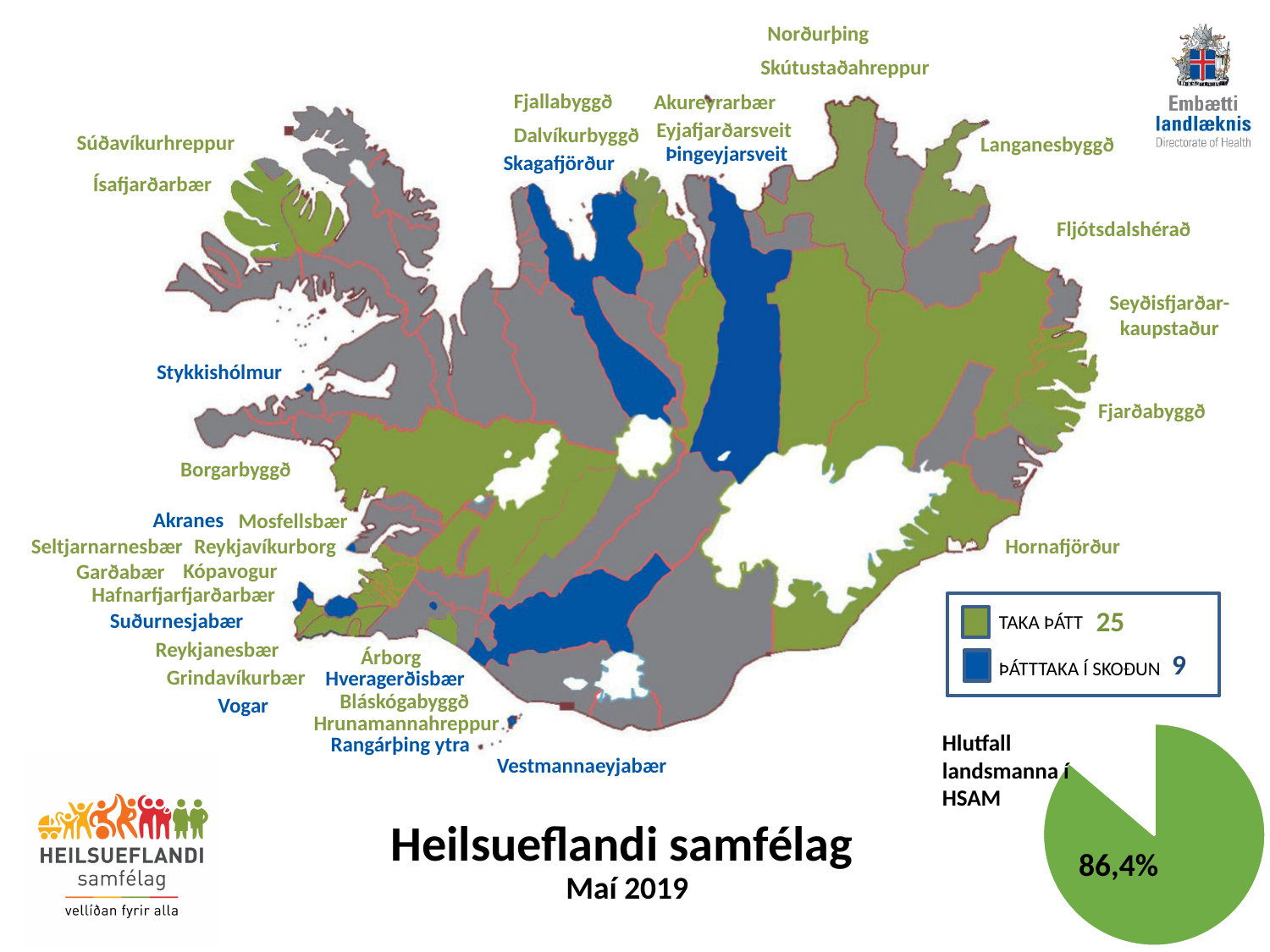
What kind of chart is shown in the bottom-right corner of the slide? pie chart What percentage is printed on the green slice of the pie chart? 86,4% In the map legend, what is the difference between the TAKA ÞÁTT number and the ÞÁTTTAKA Í SKOÐUN number? 16 What is the label next to the pie chart? Hlutfall landsmanna í HSAM What colour is the larger slice of the pie chart? green In the map legend, what number is shown for TAKA ÞÁTT? 25 In the map legend, which category has the larger number, TAKA ÞÁTT or ÞÁTTTAKA Í SKOÐUN? TAKA ÞÁTT Is the green slice of the pie chart greater or less than 50%? greater What share of the pie chart does the green slice represent? 86,4% How many slices does the pie chart have? 2 How many categories does the map legend list? 2 In the map legend, what number is shown for ÞÁTTTAKA Í SKOÐUN? 9